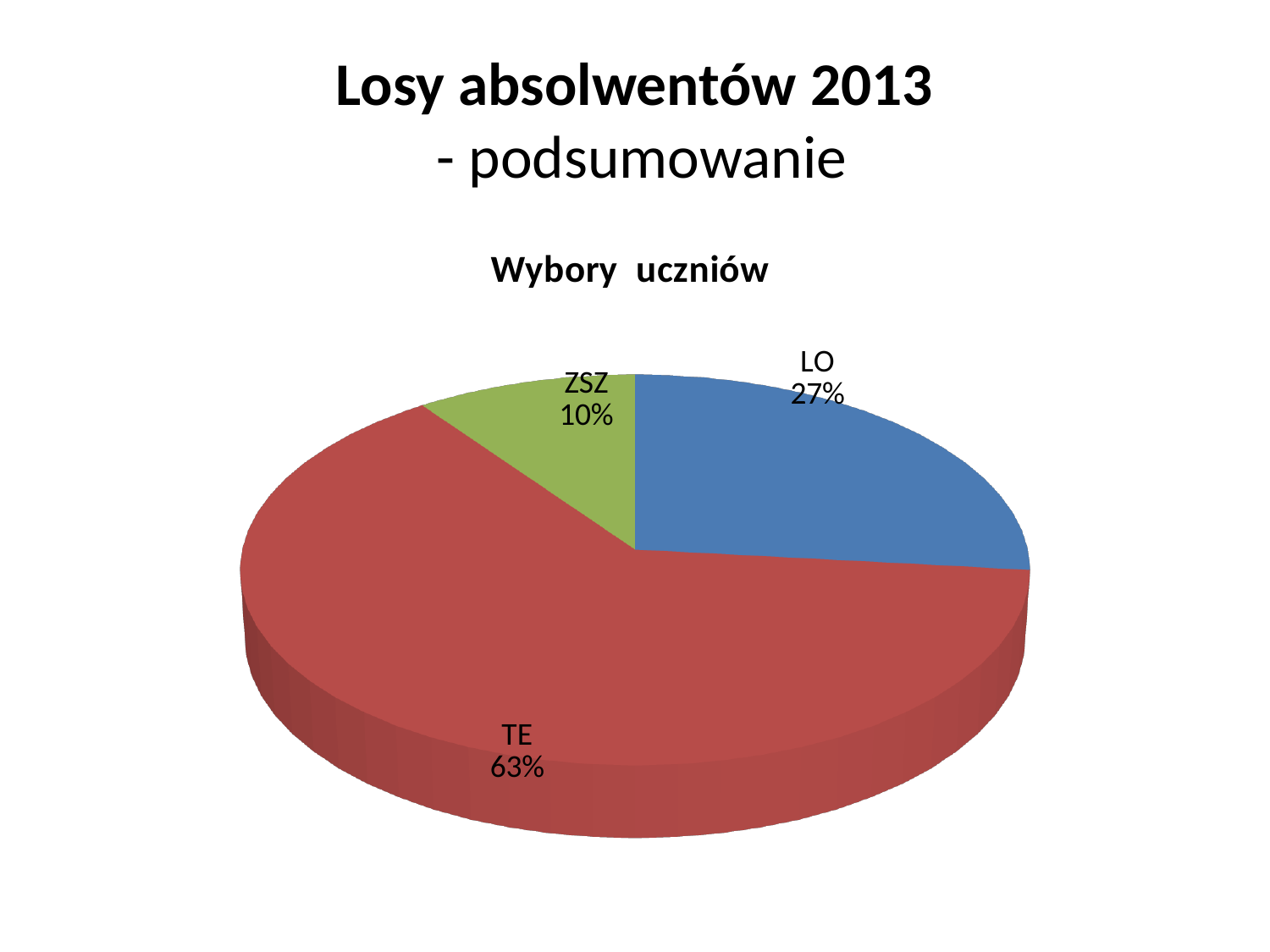
Which category has the largest slice of the pie? TE What is the difference in percentage points between TE and LO? 36 What share of the pie does TE represent? 63% What colour is the slice for TE? Red Which is larger, the share for LO or the share for ZSZ? LO What kind of chart is shown on the slide? Pie chart What is the value shown for ZSZ? 10% What is the difference in percentage points between LO and ZSZ? 17 How many categories are shown in the pie chart? 3 What is the title of the chart? Wybory uczniów Which category has the smallest slice of the pie? ZSZ What is the value shown for LO? 27%